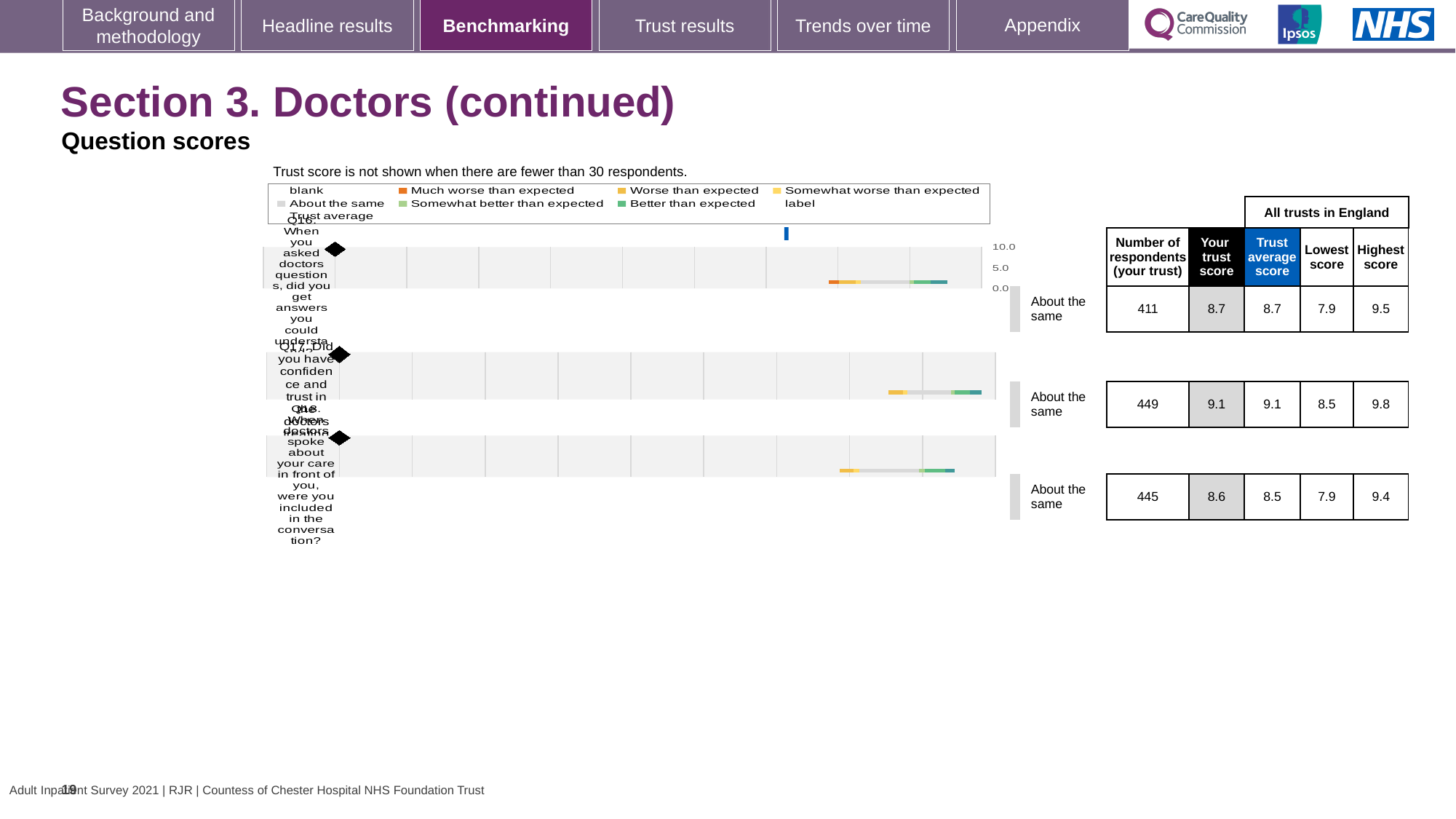
Which question has the highest 'Your trust score' on this slide? Q17 What is the trust average score for Q18 (When doctors spoke about your care in front of you, were you included in the conversation)? 8.5 What is the highest score across all trusts in England for Q17? 9.8 What is the trust score for Q17 (Did you have confidence and trust in the doctors treating you)? 9.1 Which is larger, the trust score for Q16 or the trust score for Q18? Q16 Which question has the lowest 'Your trust score' on this slide? Q18 What is the lowest score across all trusts in England for Q16? 7.9 What is the number of respondents for Q16 (When you asked doctors questions, did you get answers you could understand)? 411 What is the difference between the trust score and the trust average score for Q18? 0.1 What is the difference between the highest and lowest scores for Q17? 1.3 How many questions are plotted in the chart on this slide? 3 What benchmark category is shown for Q16, Q17 and Q18? About the same